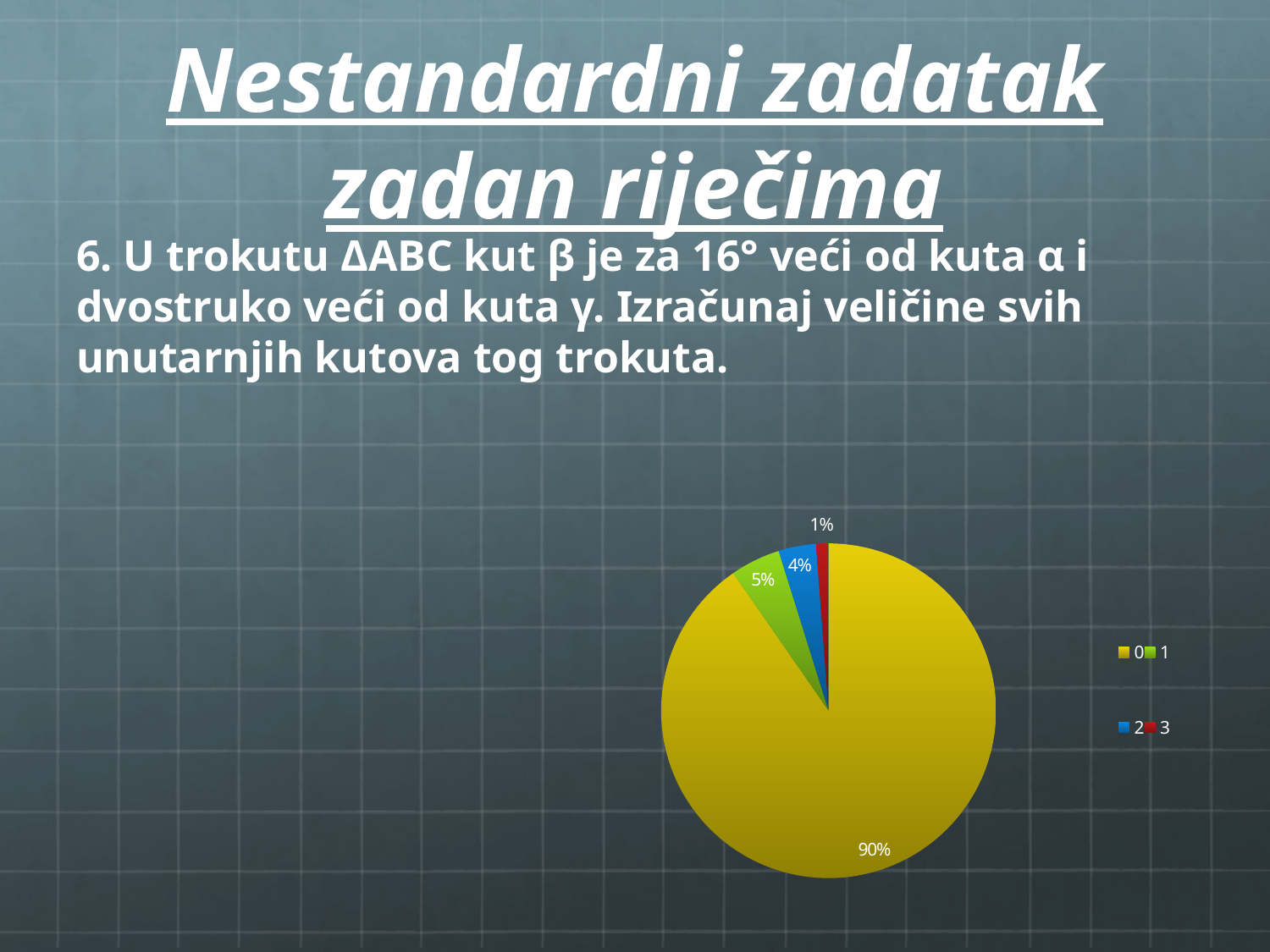
Which category has the smallest slice of the pie? 3 What colour is the slice for category 0? yellow What share of the pie does category 0 have? 90% What share of the pie does category 1 have? 5% What share of the pie does category 3 have? 1% How many categories does the legend of the pie chart list? 4 What is the difference in percentage points between the slices for category 0 and category 1? 85 Which category has the largest slice of the pie? 0 What colour is the slice for category 3? red What kind of chart is shown on the slide? pie chart Which slice is larger, category 1 or category 2? 1